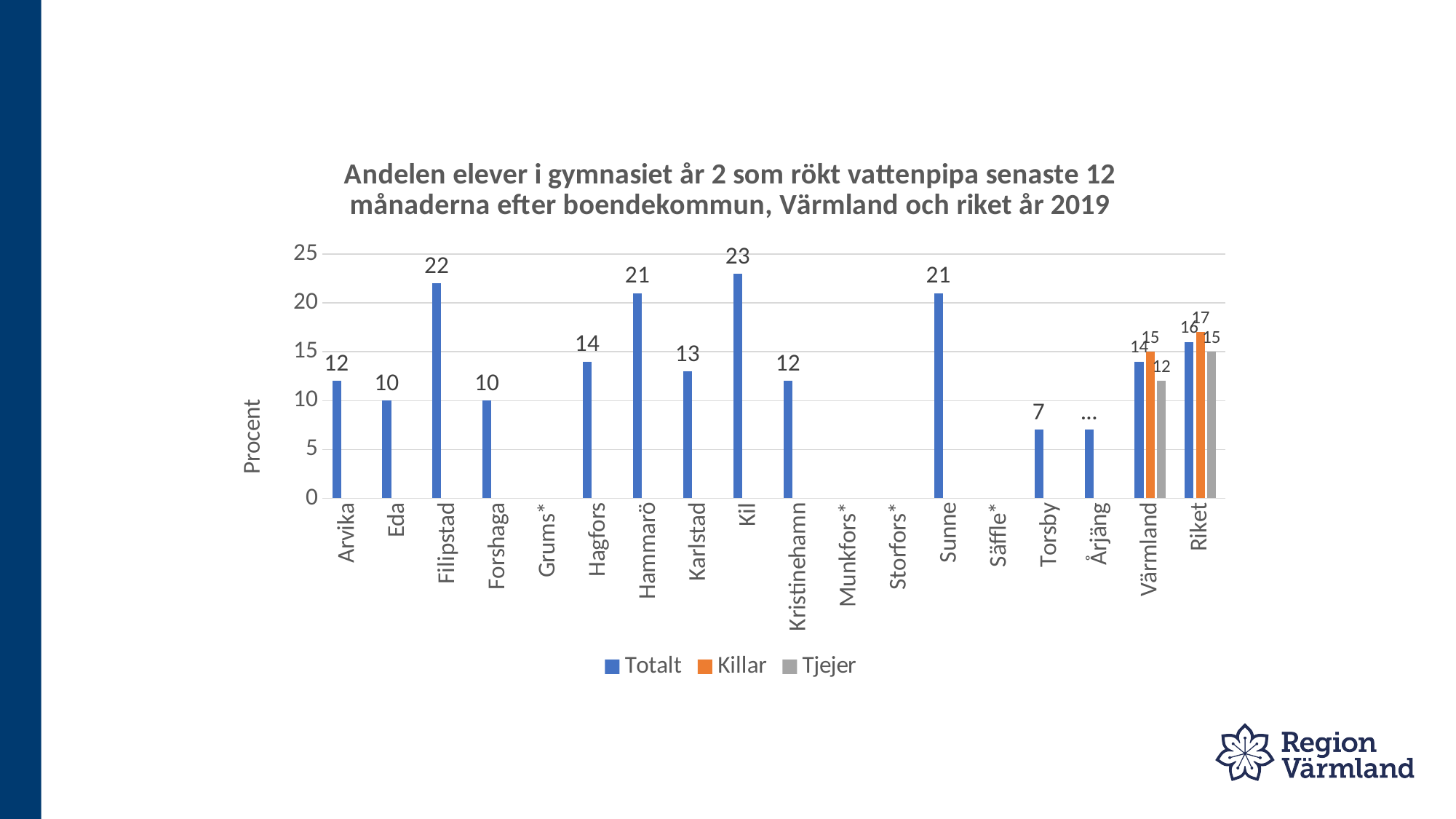
Which municipality has the highest value? Kil What is the Tjejer value for Riket? 15 What kind of chart is shown on the slide? bar chart Is the value for Årjäng greater or less than 10? less What is the value for Kil? 23 What is the difference between the values for Kil and Filipstad? 1 What is the Totalt value for Filipstad? 22 What is the difference between the Killar and Tjejer values for Riket? 2 What is the Killar value for Värmland? 15 Which is larger, the value for Hammarö or the value for Karlstad? Hammarö How many series does the legend list? 3 How many categories are shown on the x axis? 18